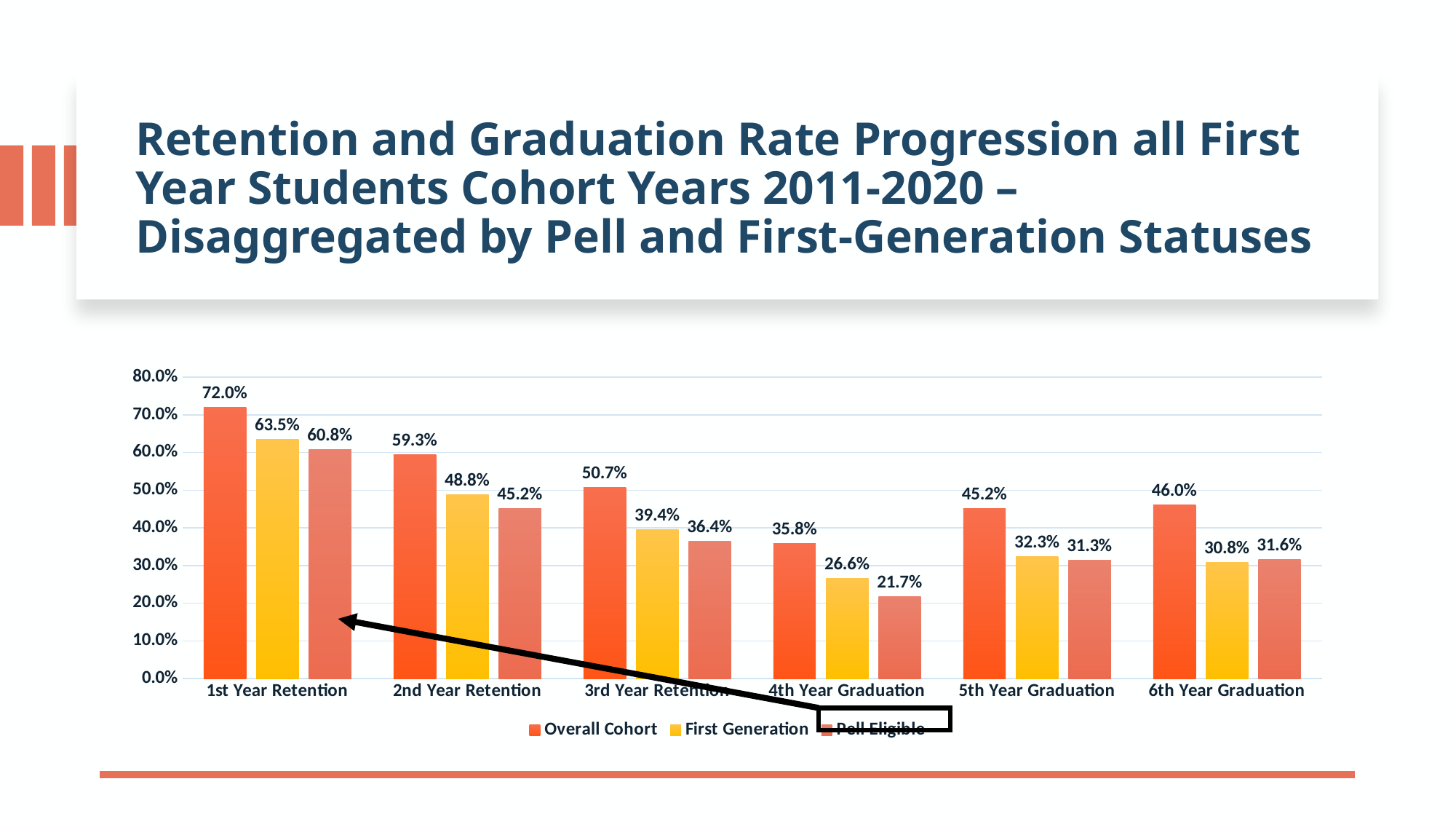
Which category has the highest Overall Cohort value? 1st Year Retention Which category has the lowest Pell Eligible value? 4th Year Graduation How many categories are shown on the x axis? 6 How many series does the legend list? 3 What is the First Generation value for 3rd Year Retention? 39.4% What is the Pell Eligible value for 4th Year Graduation? 21.7% What kind of chart is shown on the slide? Bar chart Do the Overall Cohort values rise or fall from 1st Year Retention to 4th Year Graduation? Fall Which is larger for 6th Year Graduation: the First Generation value or the Pell Eligible value? Pell Eligible What is the Overall Cohort value for 1st Year Retention? 72.0% What is the difference between the Overall Cohort and First Generation values for 2nd Year Retention? 10.5% Is the Overall Cohort value for 5th Year Graduation greater or less than 40.0%? greater